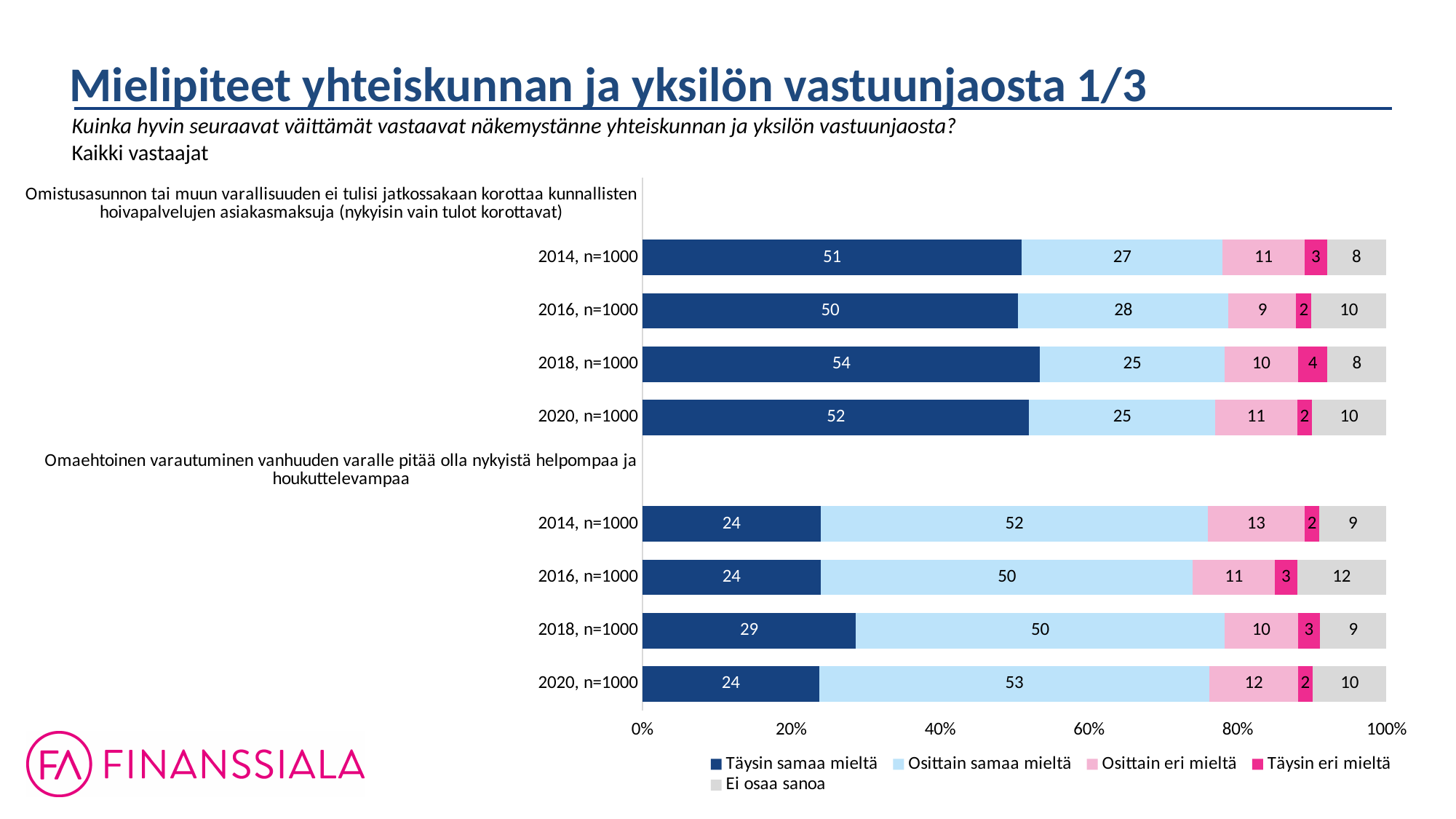
Under the statement 'Omistusasunnon tai muun varallisuuden ei tulisi jatkossakaan korottaa kunnallisten hoivapalvelujen asiakasmaksuja', which year has the highest 'Täysin samaa mieltä' value? 2018, n=1000 What is the 'Täysin samaa mieltä' value for 2018, n=1000 under the statement 'Omistusasunnon tai muun varallisuuden ei tulisi jatkossakaan korottaa kunnallisten hoivapalvelujen asiakasmaksuja'? 54 Under the statement 'Omistusasunnon tai muun varallisuuden ei tulisi jatkossakaan korottaa kunnallisten hoivapalvelujen asiakasmaksuja', is the 'Osittain samaa mieltä' value larger for 2016, n=1000 or for 2020, n=1000? 2016, n=1000 What is the difference between the 'Täysin samaa mieltä' values for 2018, n=1000 and 2014, n=1000 under the statement 'Omaehtoinen varautuminen vanhuuden varalle pitää olla nykyistä helpompaa ja houkuttelevampaa'? 5 What is the 'Osittain samaa mieltä' value for 2020, n=1000 under the statement 'Omaehtoinen varautuminen vanhuuden varalle pitää olla nykyistä helpompaa ja houkuttelevampaa'? 53 What kind of chart is shown on the slide? Stacked bar chart How many bars are plotted in the chart? 8 Under the statement 'Omaehtoinen varautuminen vanhuuden varalle pitää olla nykyistä helpompaa ja houkuttelevampaa', which year has the lowest 'Osittain eri mieltä' value? 2018, n=1000 Which legend entry is shown in the darkest blue colour? Täysin samaa mieltä How many series does the legend list? 5 What is the combined 'Täysin samaa mieltä' and 'Osittain samaa mieltä' value for 2014, n=1000 under the statement 'Omistusasunnon tai muun varallisuuden ei tulisi jatkossakaan korottaa kunnallisten hoivapalvelujen asiakasmaksuja'? 78 What is the 'Ei osaa sanoa' value for 2016, n=1000 under the statement 'Omaehtoinen varautuminen vanhuuden varalle pitää olla nykyistä helpompaa ja houkuttelevampaa'? 12